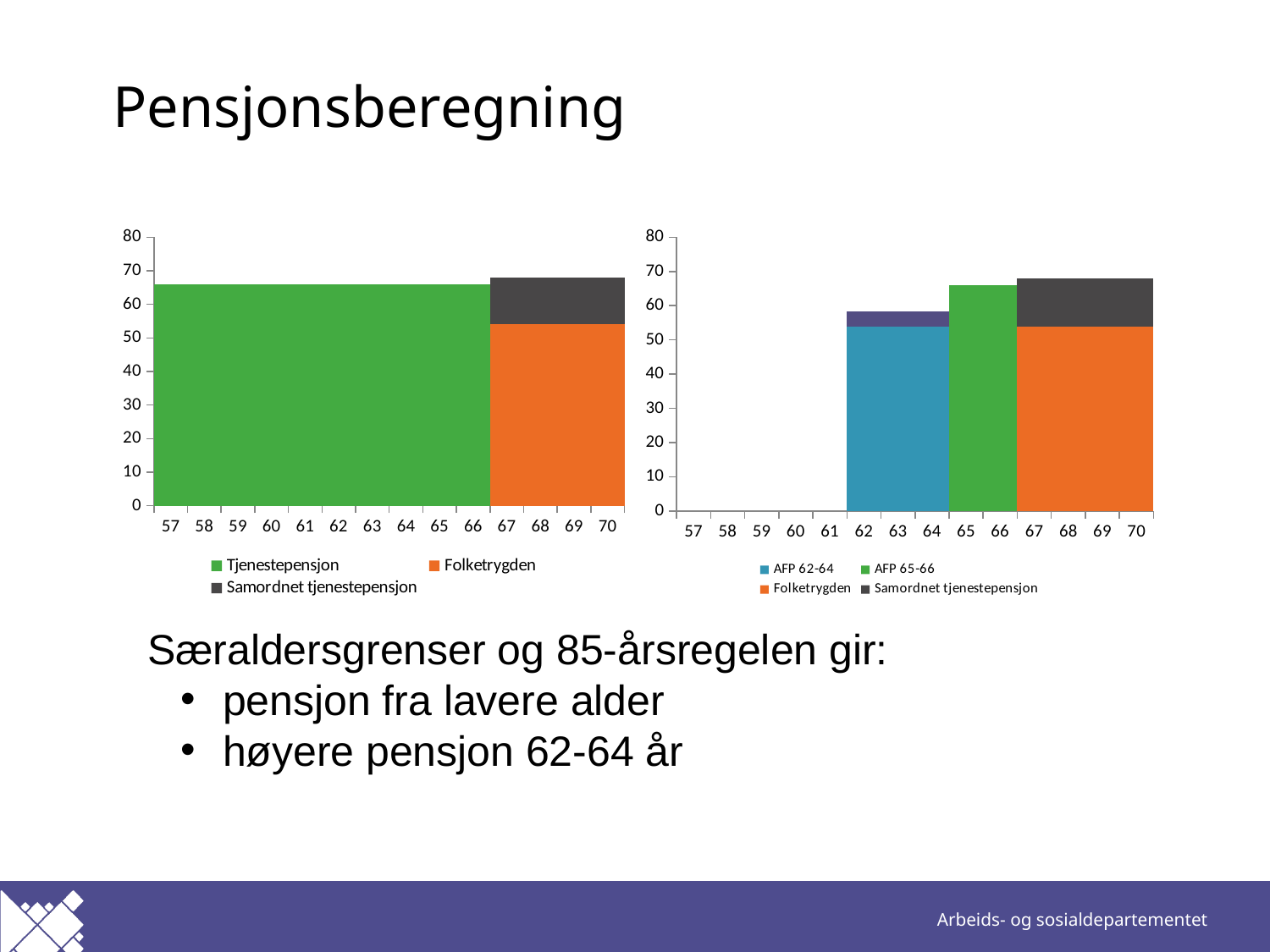
What is the highest value shown on the y axis of the right chart? 80 How many age categories are shown on the x axis of the left chart? 14 In the left chart, which is larger: Tjenestepensjon at age 60 or Folketrygden at age 68? Tjenestepensjon at age 60 What kind of chart is the left chart on the slide? Stacked bar chart How many series does the legend of the right chart list? 4 In the left chart, is the value for Folketrygden at age 68 greater or less than 50? greater In the right chart, which is larger: the AFP 65-66 bar at age 65 or the AFP 62-64 segment at age 63? AFP 65-66 at age 65 In the left chart, is the value for Tjenestepensjon at age 60 greater or less than 60? greater In the right chart, is the value for AFP 62-64 at age 63 greater or less than 50? greater How many series does the legend of the left chart list? 3